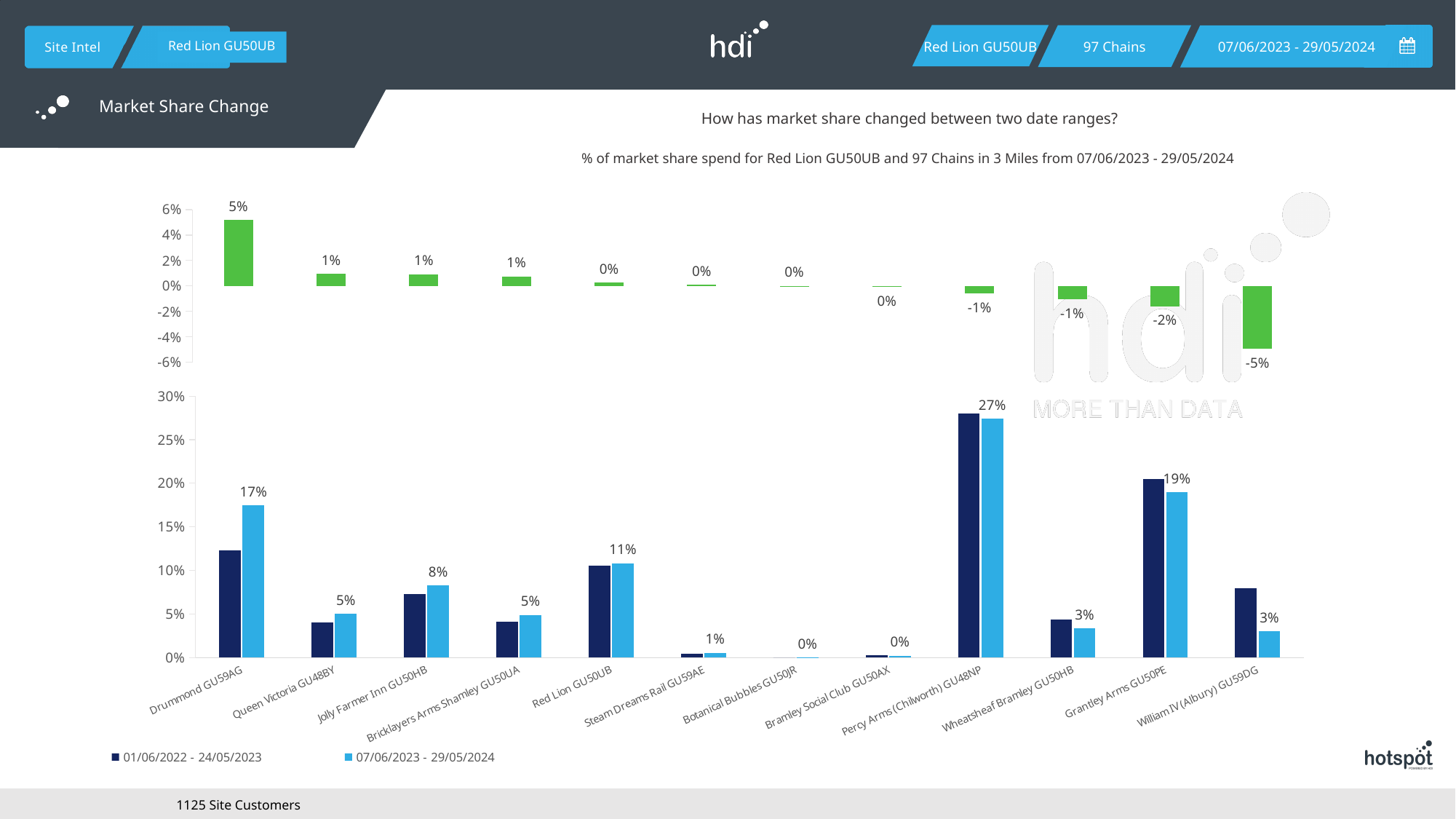
In the top chart (market share change), what is the value for William IV (Albury) GU59DG? -5% In the top chart (market share change), what is the value for Drummond GU59AG? 5% In the top chart (market share change), which category has the lowest value? William IV (Albury) GU59DG In the bottom chart, what is the 07/06/2023 - 29/05/2024 value for Percy Arms (Chilworth) GU48NP? 27% In the bottom chart, what is the difference between the 07/06/2023 - 29/05/2024 values for Grantley Arms GU50PE and Drummond GU59AG? 2% In the top chart (market share change), what is the value for Grantley Arms GU50PE? -2% In the bottom chart, what is the 07/06/2023 - 29/05/2024 value for Red Lion GU50UB? 11% In the bottom chart, is the 01/06/2022 - 24/05/2023 value for Drummond GU59AG greater or less than 10%? greater In the bottom chart, is the 01/06/2022 - 24/05/2023 value for William IV (Albury) GU59DG greater or less than 5%? greater How many series does the legend of the bottom chart list? 2 In the bottom chart, which category has the highest 07/06/2023 - 29/05/2024 value? Percy Arms (Chilworth) GU48NP How many categories are shown on the x axis of the bottom chart? 12